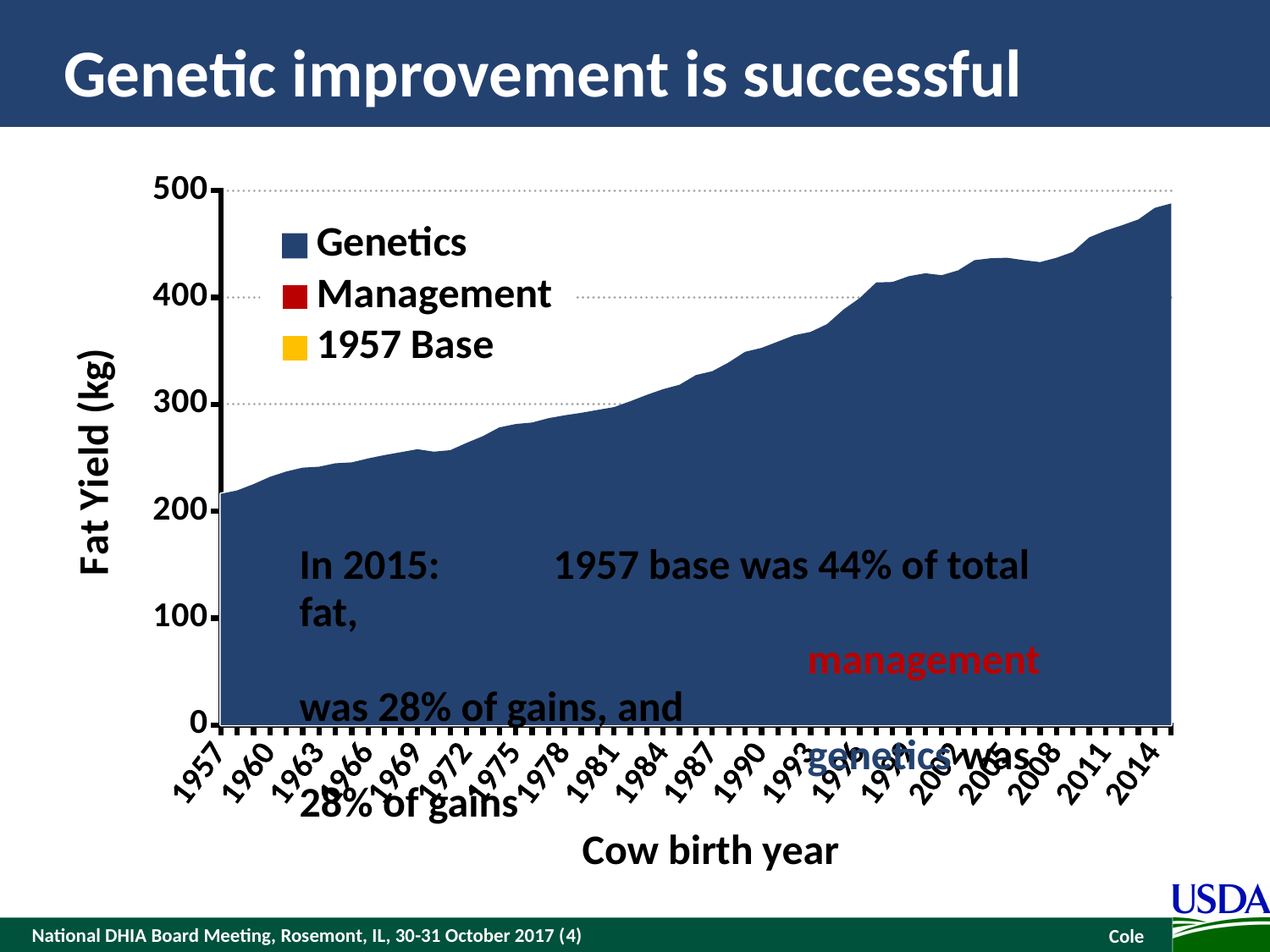
What kind of chart is shown on the slide? area chart Which cow birth year has the lowest fat yield? 1957 What is the label of the y axis? Fat Yield (kg) How many series does the legend list? 3 Is the fat yield for cows born in 1972 greater or less than 300? less Is the fat yield for cows born in 1990 greater or less than 300? greater Is the fat yield for cows born in 1957 greater or less than 300? less Which is larger, the fat yield for cows born in 1963 or for cows born in 2005? 2005 Which cow birth year has the highest fat yield? 2015 Does fat yield rise or fall as cow birth year increases from 1957 to 2014? rise